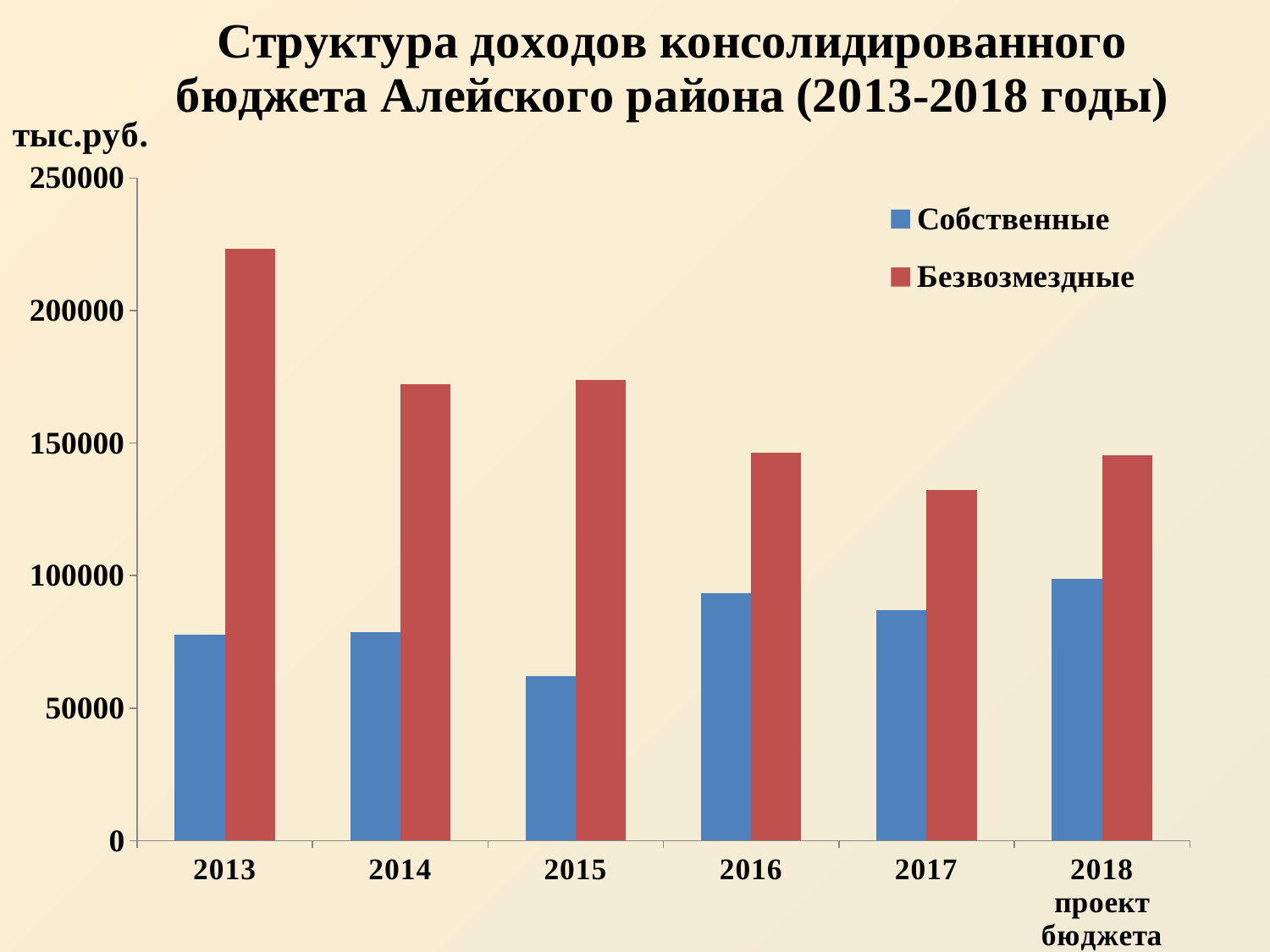
In which year is the value for Безвозмездные the lowest? 2017 Which year has the larger value for Собственные: 2015 or 2016? 2016 In which year is the value for Безвозмездные the highest? 2013 How many years (categories) are shown on the x axis? 6 What kind of chart is shown on the slide? bar chart How many series does the legend list? 2 Is the value for Безвозмездные in 2017 greater or less than 150000? less What unit is shown above the vertical axis? тыс.руб. Is the value for Собственные in 2016 greater or less than 100000? less Which is larger in 2015: Собственные or Безвозмездные? Безвозмездные In which year is the value for Собственные the lowest? 2015 Is the value for Безвозмездные in 2013 greater or less than 200000? greater